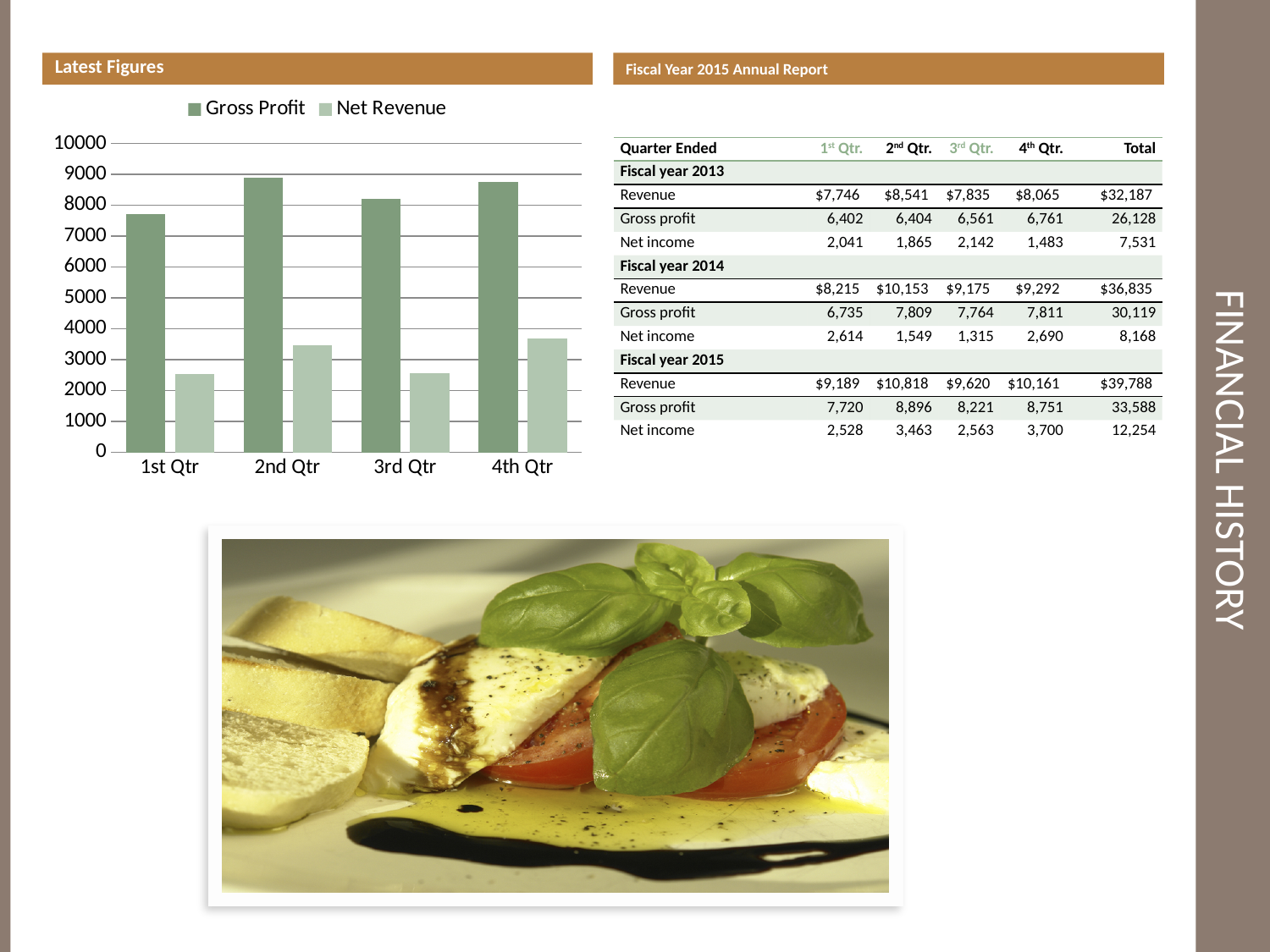
What are the two series named in the chart legend? Gross Profit and Net Revenue Is the Net Revenue value for 2nd Qtr greater or less than 3000? greater Is the Gross Profit value for 1st Qtr greater or less than 7000? greater What kind of chart is shown under the 'Latest Figures' heading? bar chart Which is larger, Net Revenue in 3rd Qtr or Net Revenue in 4th Qtr? 4th Qtr Is the Gross Profit value for 3rd Qtr greater or less than 8000? greater How many series does the chart legend list? 2 Which quarter has the lowest Gross Profit bar? 1st Qtr How many quarters are shown on the x axis of the chart? 4 Which is larger, Gross Profit in 1st Qtr or Gross Profit in 2nd Qtr? 2nd Qtr Which quarter has the highest Net Revenue bar? 4th Qtr